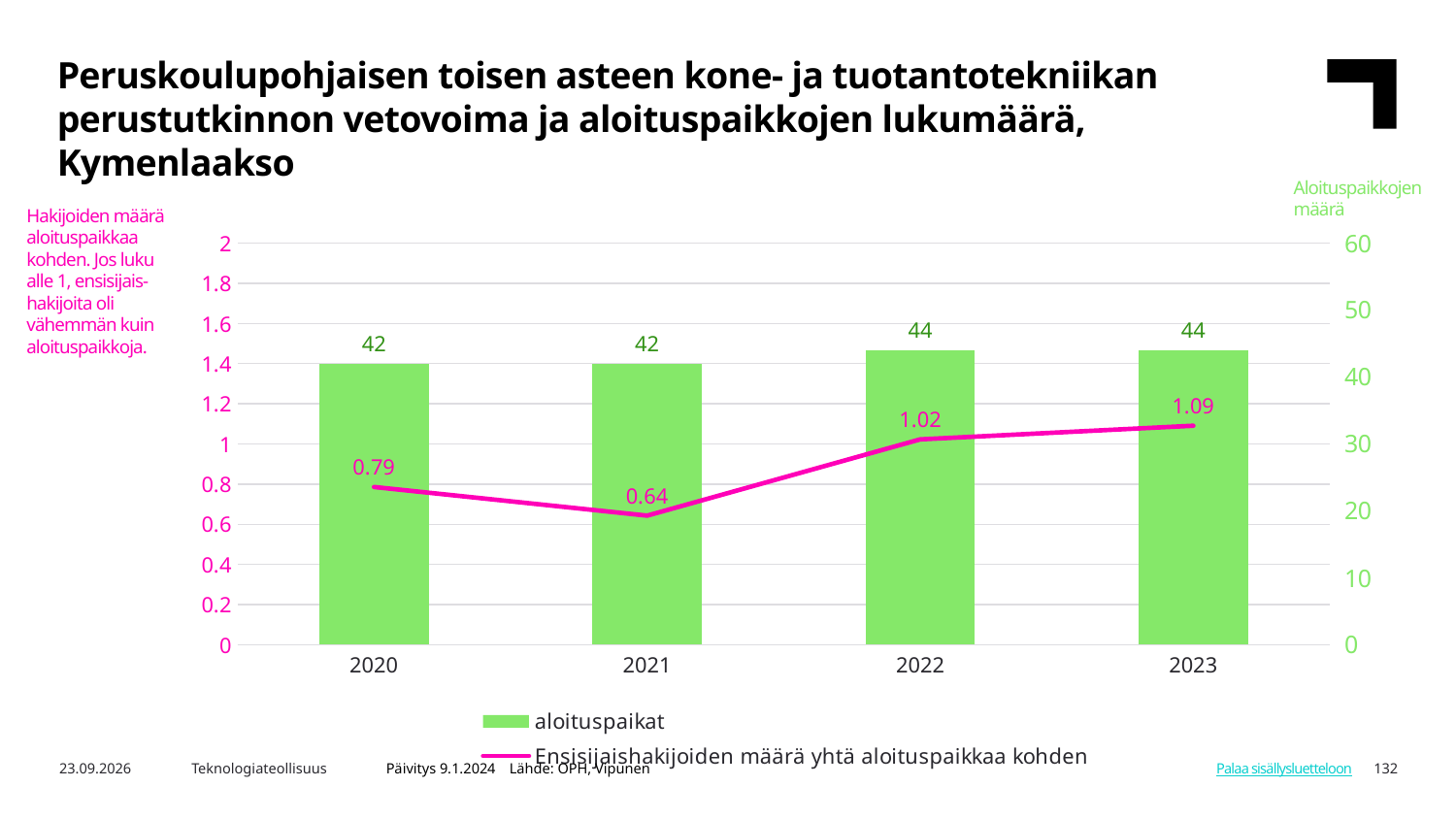
In which year is Ensisijaishakijoiden määrä yhtä aloituspaikkaa kohden highest? 2023 Does the Ensisijaishakijoiden määrä yhtä aloituspaikkaa kohden line rise or fall from 2021 to 2023? rise How many series does the legend list? 2 What is the value of aloituspaikat in 2023? 44 How many years are shown on the x axis of the chart? 4 What is the value of Ensisijaishakijoiden määrä yhtä aloituspaikkaa kohden in 2022? 1.02 What is the value of Ensisijaishakijoiden määrä yhtä aloituspaikkaa kohden in 2021? 0.64 In which year is Ensisijaishakijoiden määrä yhtä aloituspaikkaa kohden lowest? 2021 What is the value of aloituspaikat in 2020? 42 Which is larger, the Ensisijaishakijoiden määrä yhtä aloituspaikkaa kohden value in 2020 or in 2022? 2022 What is the difference in Ensisijaishakijoiden määrä yhtä aloituspaikkaa kohden between 2023 and 2021? 0.45 What is the difference in aloituspaikat between 2022 and 2020? 2